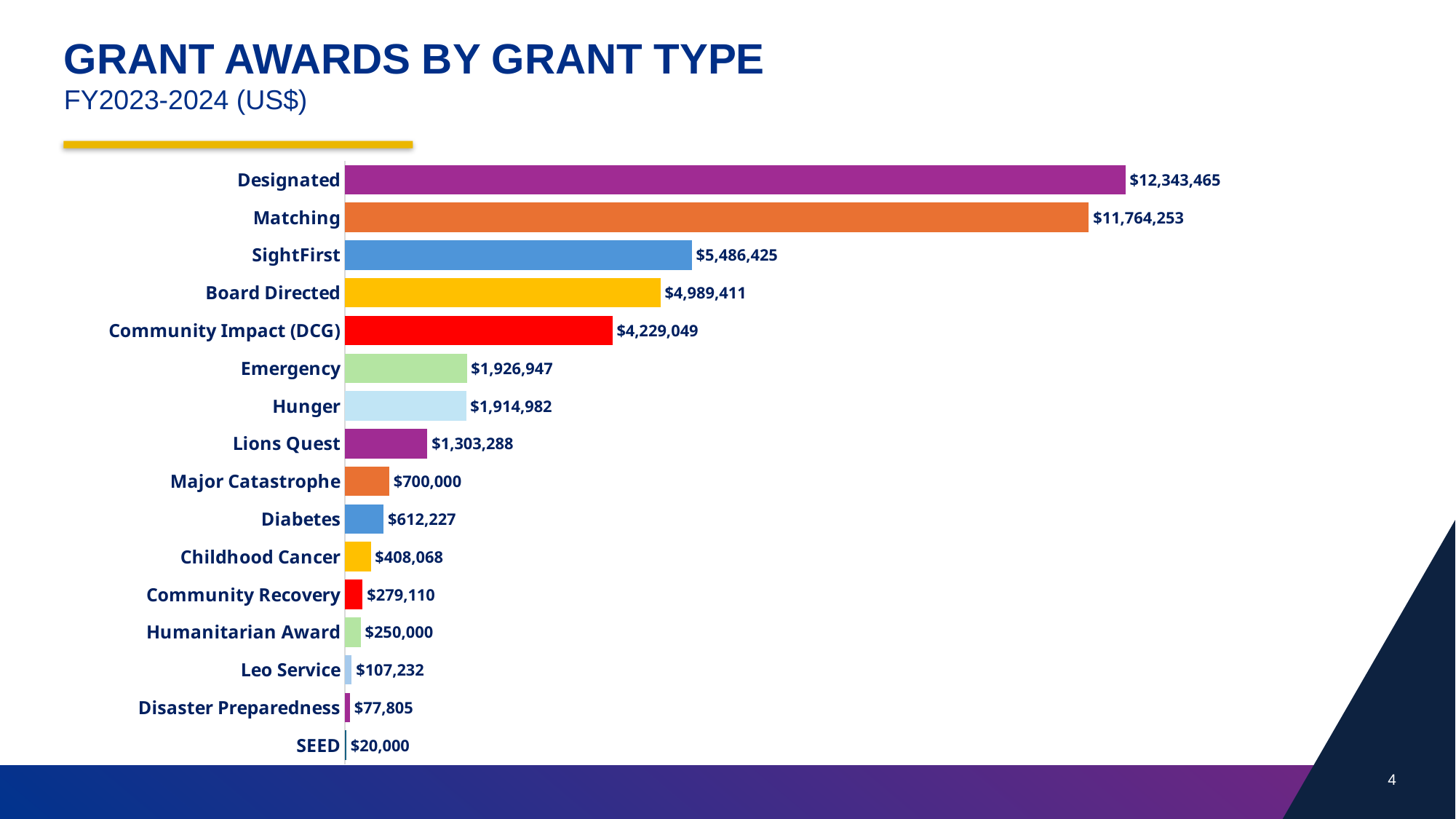
Which grant type has the highest award amount? Designated Which grant type has the lowest award amount? SEED What is the difference between the Designated and Matching grant award amounts? $579,212 What is the grant award amount for SightFirst? $5,486,425 How many grant types are shown in the chart? 16 What is the grant award amount for Leo Service? $107,232 What kind of chart is shown on the slide? Bar chart What fiscal year and currency does the chart subtitle indicate? FY2023-2024 (US$) What is the grant award amount for Lions Quest? $1,303,288 What is the difference between the Major Catastrophe and Diabetes grant award amounts? $87,773 Which has a larger grant award amount, Board Directed or Community Impact (DCG)? Board Directed Which has a larger grant award amount, Childhood Cancer or Community Recovery? Childhood Cancer